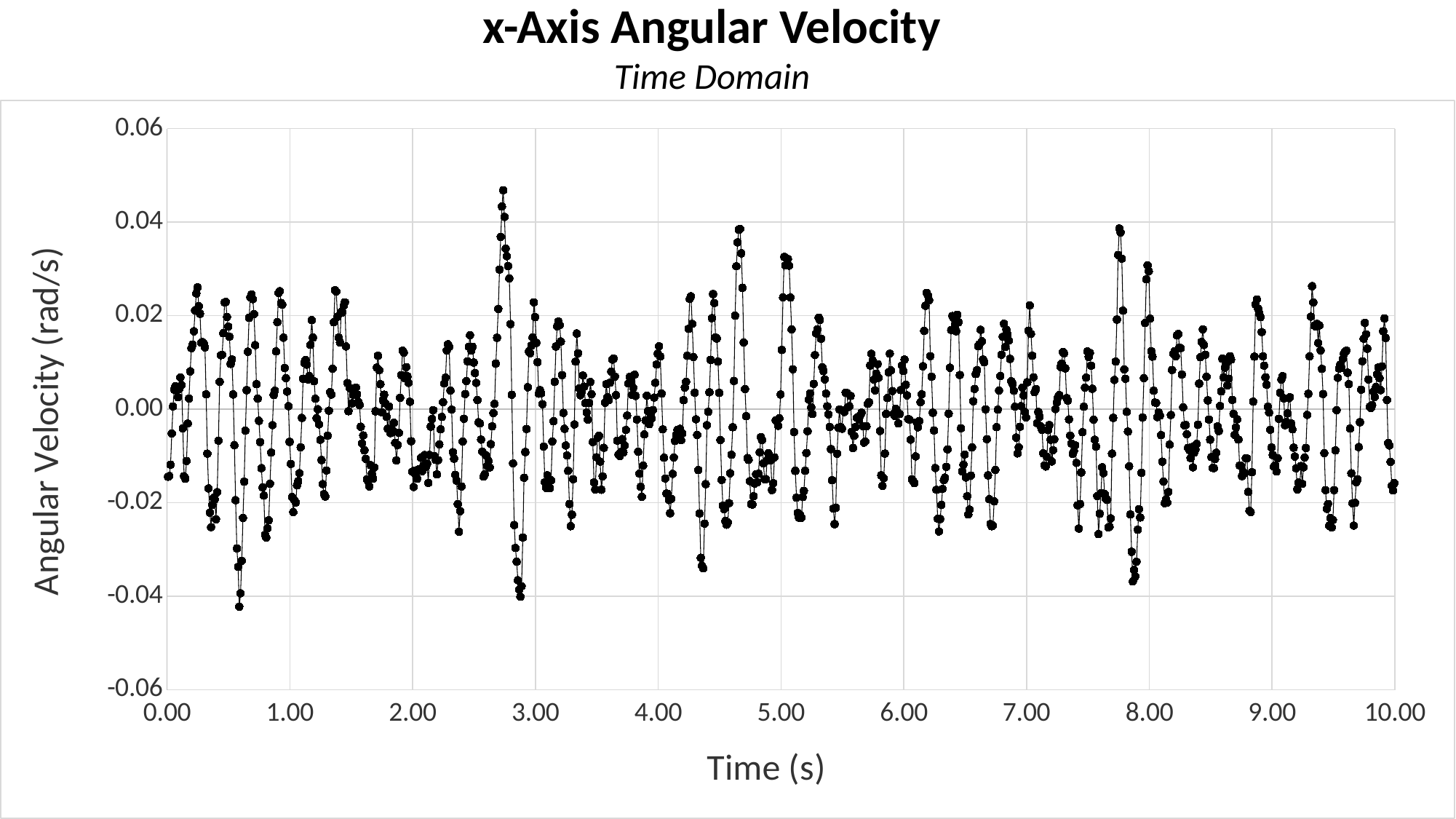
Between which two x-axis tick labels does the lowest plotted value occur? 0.00 and 1.00 Between which two x-axis tick labels does the highest plotted value occur? 2.00 and 3.00 Which is lower: the minimum value between 0.00 and 1.00 s or the minimum value between 4.00 and 5.00 s? The minimum between 0.00 and 1.00 s Is the highest value plotted on the chart greater or less than 0.04? greater Is the peak value between 4.00 and 5.00 s greater or less than 0.02? greater Is the lowest value plotted on the chart greater or less than -0.04? less What is the title of the chart? x-Axis Angular Velocity What kind of chart is shown on the slide? Scatter chart with connected points (line chart) What is the label of the y axis? Angular Velocity (rad/s) Which is larger: the peak value between 2.00 and 3.00 s or the peak value between 4.00 and 5.00 s? The peak between 2.00 and 3.00 s